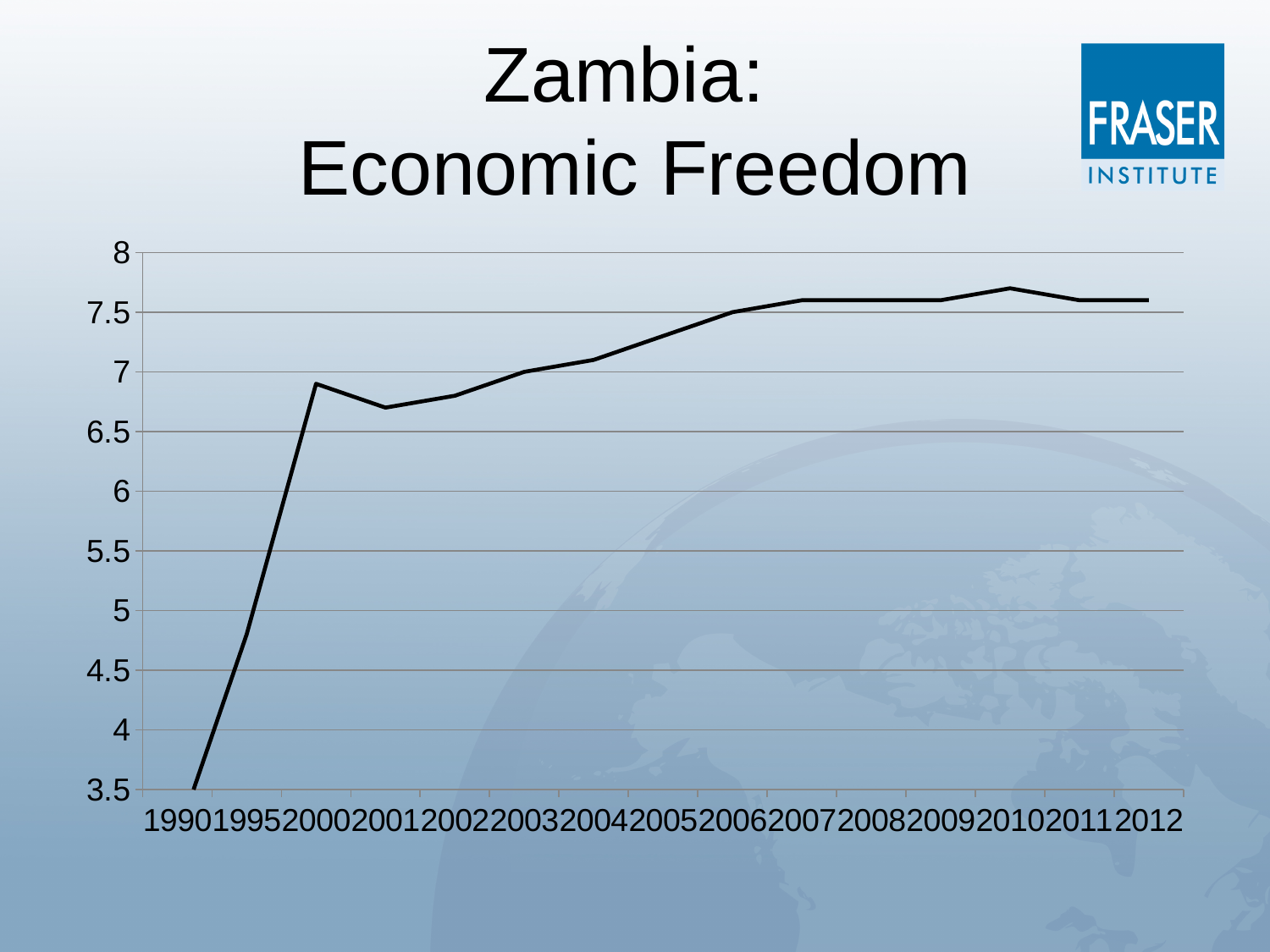
Which year has the highest value? 2010 What kind of chart is shown on the slide? line chart Which year has the larger value, 2000 or 2001? 2000 How many years are plotted along the x axis? 15 Is the value for 2012 greater or less than 7.5? greater Is the value for 2004 greater or less than 7? greater Is the value for 1995 greater or less than 5? less What is the title of the slide? Zambia: Economic Freedom Overall, do the values rise or fall from 1990 to 2012? rise Which year has the lowest value? 1990